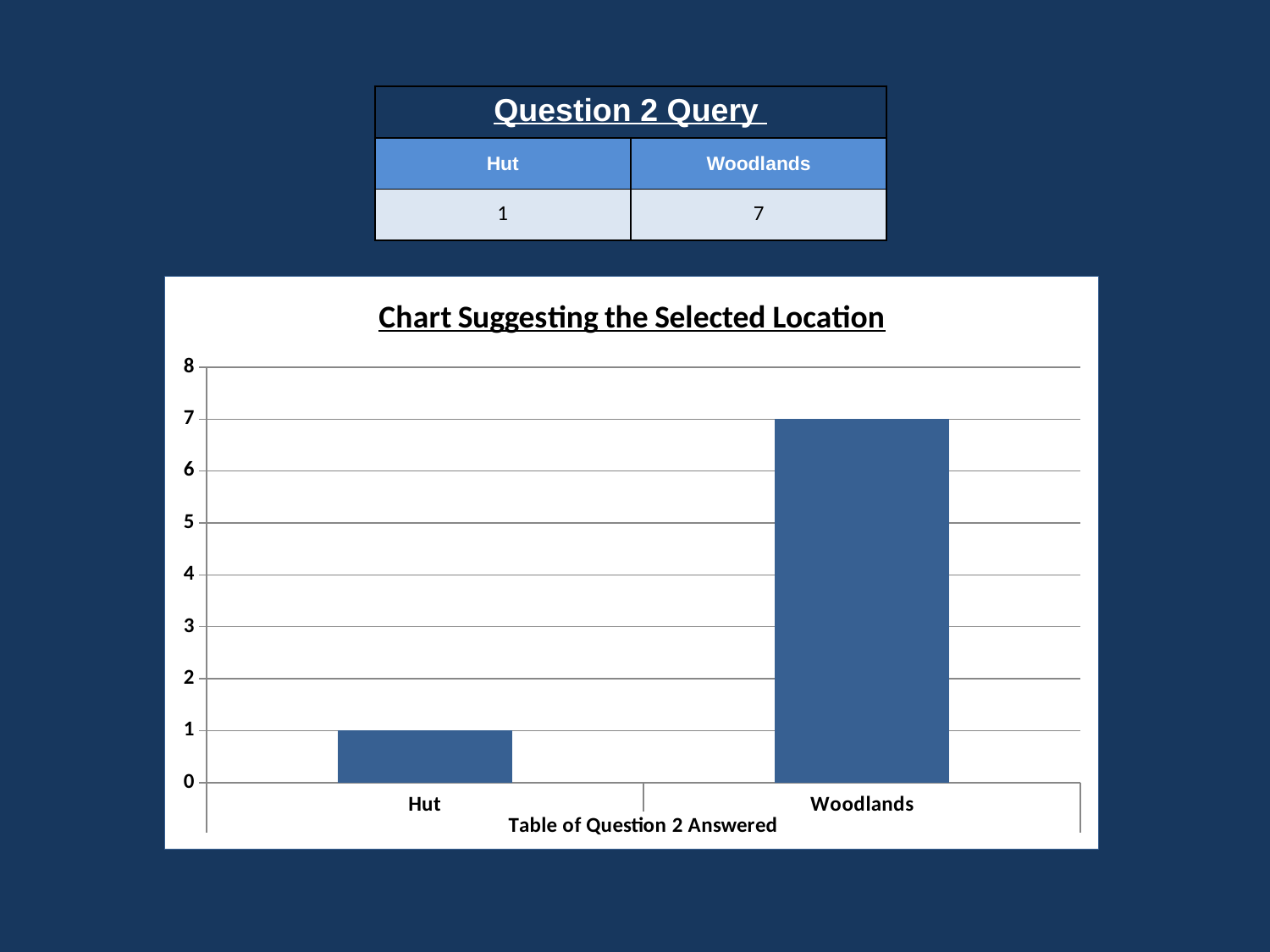
Which category has the highest value in the chart? Woodlands What is the value for Woodlands in the chart? 7 What is the title of the chart? Chart Suggesting the Selected Location What is the difference between the values for Woodlands and Hut? 6 What is the label on the x axis of the chart? Table of Question 2 Answered What is the value for Hut in the chart? 1 Is the value for Woodlands greater or less than 4? greater Which is larger, the value for Hut or the value for Woodlands? Woodlands Is the value for Hut greater or less than 2? less Which category has the lowest value in the chart? Hut What kind of chart is shown on the slide? bar chart How many categories are shown in the chart? 2